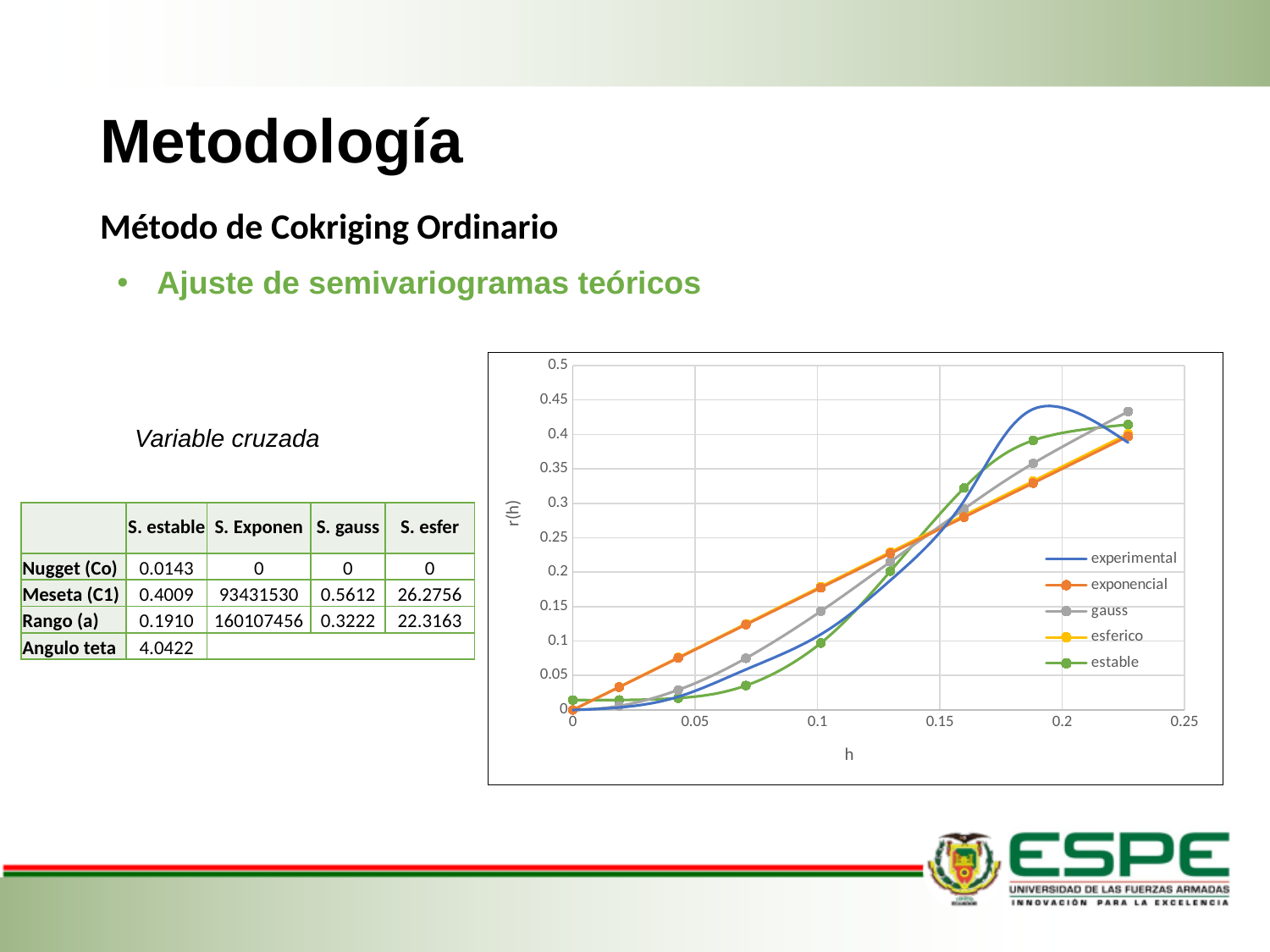
How many series does the chart legend list? 5 Is the value of the exponencial series at h = 0.1 greater or less than 0.2? less At the rightmost plotted point (h about 0.23), which series has the larger value, gauss or exponencial? gauss Which series reaches the highest value at the rightmost plotted point (h about 0.23)? gauss Do the values of the exponencial series rise or fall as h increases? rise What kind of chart is shown on the slide? line chart Is the value of the gauss series at its rightmost point (h about 0.23) greater or less than 0.4? greater What is the label of the chart's x axis? h Is the peak value of the experimental series greater or less than 0.4? greater At h = 0.05, which series has the larger value, exponencial or estable? exponencial What are the series names listed in the chart legend? experimental, exponencial, gauss, esferico, estable